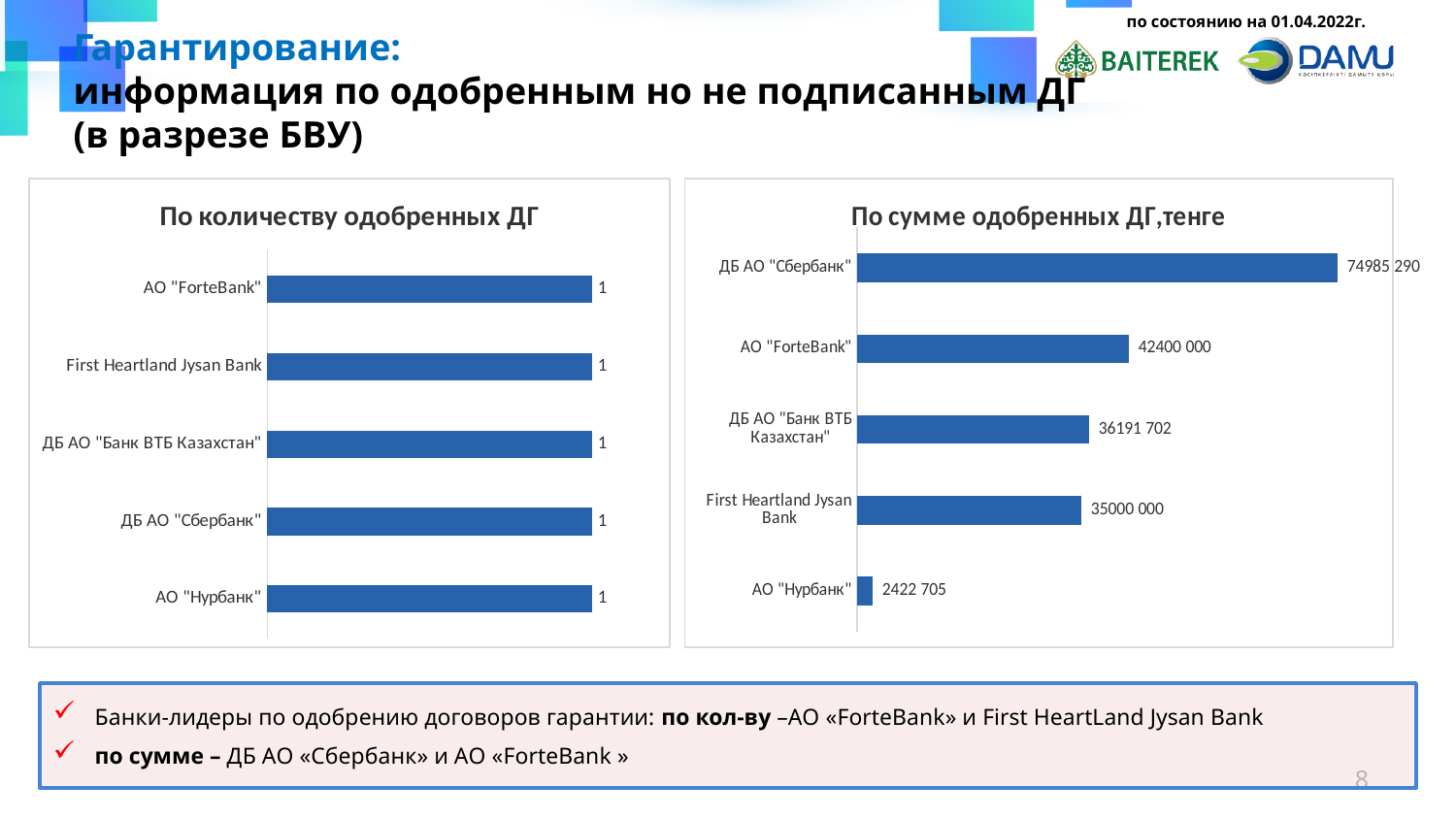
In the chart titled "По сумме одобренных ДГ,тенге", what is the difference between the values for ДБ АО "Сбербанк" and АО "ForteBank"? 32585 290 In the chart titled "По сумме одобренных ДГ,тенге", which bank has the lowest value? АО "Нурбанк" In the chart titled "По сумме одобренных ДГ,тенге", which bank has the highest value? ДБ АО "Сбербанк" What kind of chart is the chart titled "По сумме одобренных ДГ,тенге"? Bar chart In the chart titled "По количеству одобренных ДГ", what is the value for ДБ АО "Сбербанк"? 1 How many banks are shown in the chart titled "По количеству одобренных ДГ"? 5 In the chart titled "По сумме одобренных ДГ,тенге", what is the value for АО "ForteBank"? 42400 000 What is the title of the chart on the left side of the slide? По количеству одобренных ДГ In the chart titled "По сумме одобренных ДГ,тенге", what is the value for АО "Нурбанк"? 2422 705 In the chart titled "По сумме одобренных ДГ,тенге", what is the value for First Heartland Jysan Bank? 35000 000 In the chart titled "По сумме одобренных ДГ,тенге", what is the value for ДБ АО "Сбербанк"? 74985 290 In the chart titled "По сумме одобренных ДГ,тенге", which is larger: the value for ДБ АО "Банк ВТБ Казахстан" or for First Heartland Jysan Bank? ДБ АО "Банк ВТБ Казахстан"